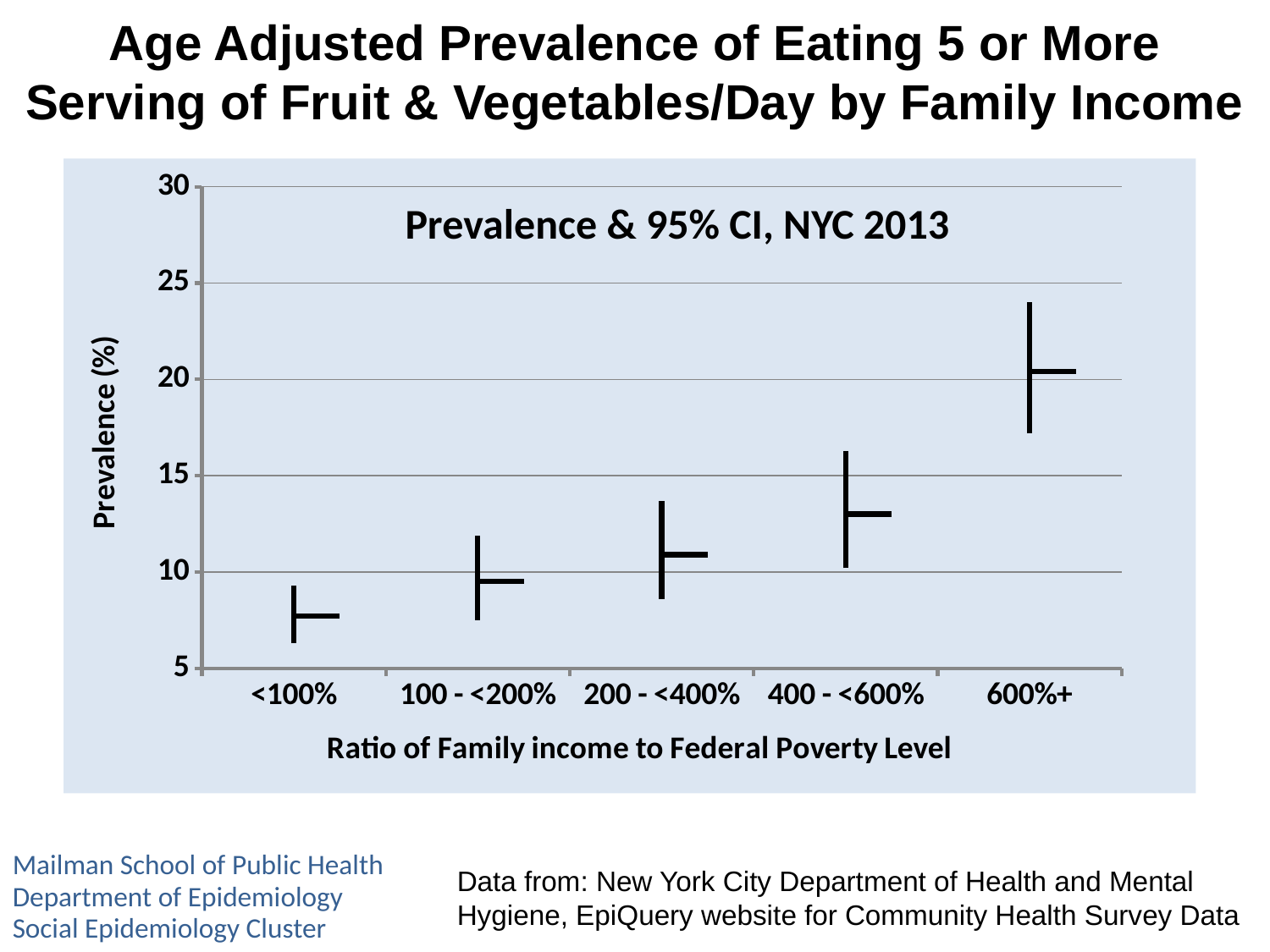
What is the label of the x axis? Ratio of Family income to Federal Poverty Level Is the prevalence for the <100% category greater or less than 10? less Which has a higher prevalence, the 400 - <600% category or the 100 - <200% category? 400 - <600% Which has a higher prevalence, the 600%+ category or the <100% category? 600%+ Which income category has the highest prevalence? 600%+ Which income category has the lowest prevalence? <100% Is the prevalence for the 600%+ category greater or less than 15? greater How many income categories are shown on the x axis? 5 Is the prevalence for the 200 - <400% category greater or less than 10? greater Does prevalence rise or fall as the ratio of family income to the federal poverty level increases? rises What is the title shown inside the chart area? Prevalence & 95% CI, NYC 2013